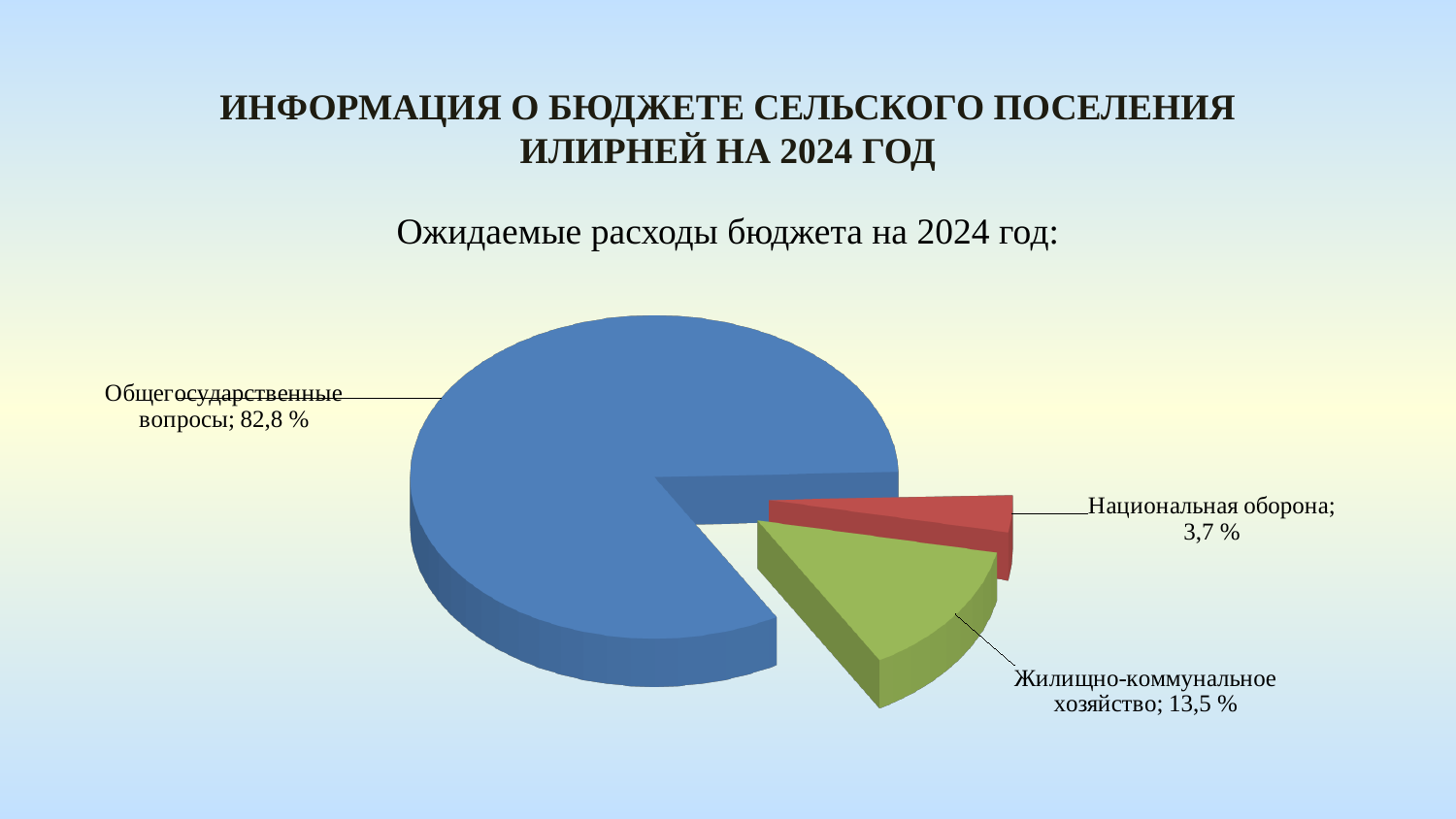
Which category has the smallest slice of the pie? Национальная оборона What share of the pie does "Национальная оборона" have? 3,7 % What kind of chart is shown on the slide? pie chart What is the difference in percentage points between "Жилищно-коммунальное хозяйство" and "Национальная оборона"? 9,8 Which is larger: the slice for "Жилищно-коммунальное хозяйство" or the slice for "Национальная оборона"? Жилищно-коммунальное хозяйство What share of the pie does "Общегосударственные вопросы" have? 82,8 % Which category has the largest slice of the pie? Общегосударственные вопросы What is the subtitle written directly above the pie chart? Ожидаемые расходы бюджета на 2024 год: How many slices does the pie chart have? 3 What is the difference in percentage points between "Общегосударственные вопросы" and "Жилищно-коммунальное хозяйство"? 69,3 What colour is the slice for "Национальная оборона"? red What share of the pie does "Жилищно-коммунальное хозяйство" have? 13,5 %